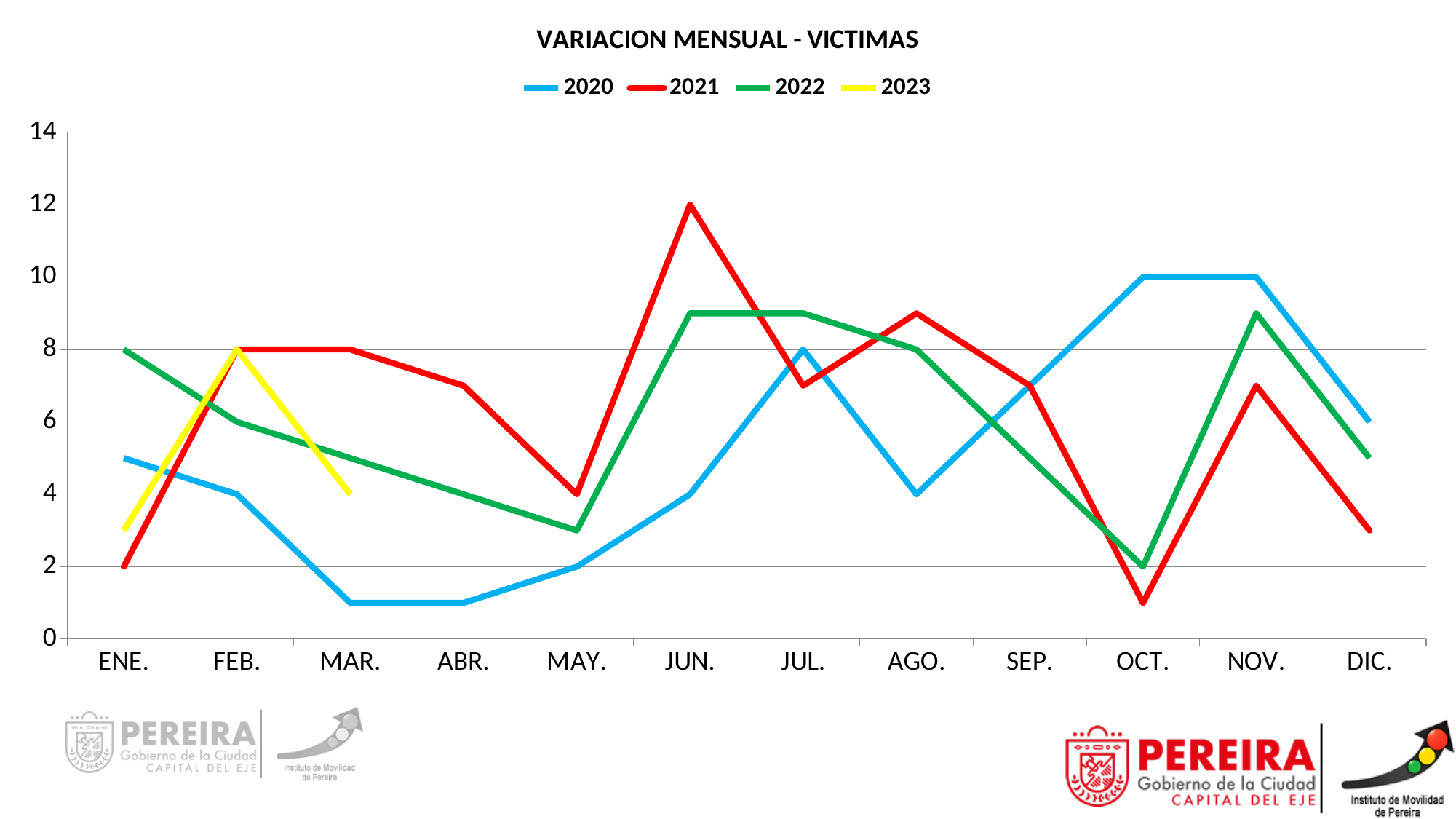
How many series does the legend list? 4 What is the value for 2021 in JUN.? 12 In which month does the 2021 series reach its highest value? JUN. In which month does the 2021 series reach its lowest value? OCT. Which series has the larger value in OCT., 2020 or 2021? 2020 Does the 2023 series rise or fall from FEB. to MAR.? fall What is the value for 2022 in ENE.? 8 What is the value for 2020 in OCT.? 10 What kind of chart is shown on the slide? line chart How many months are shown on the x axis? 12 Is the value for 2021 in DIC. greater or less than 4? less What is the value for 2023 in FEB.? 8